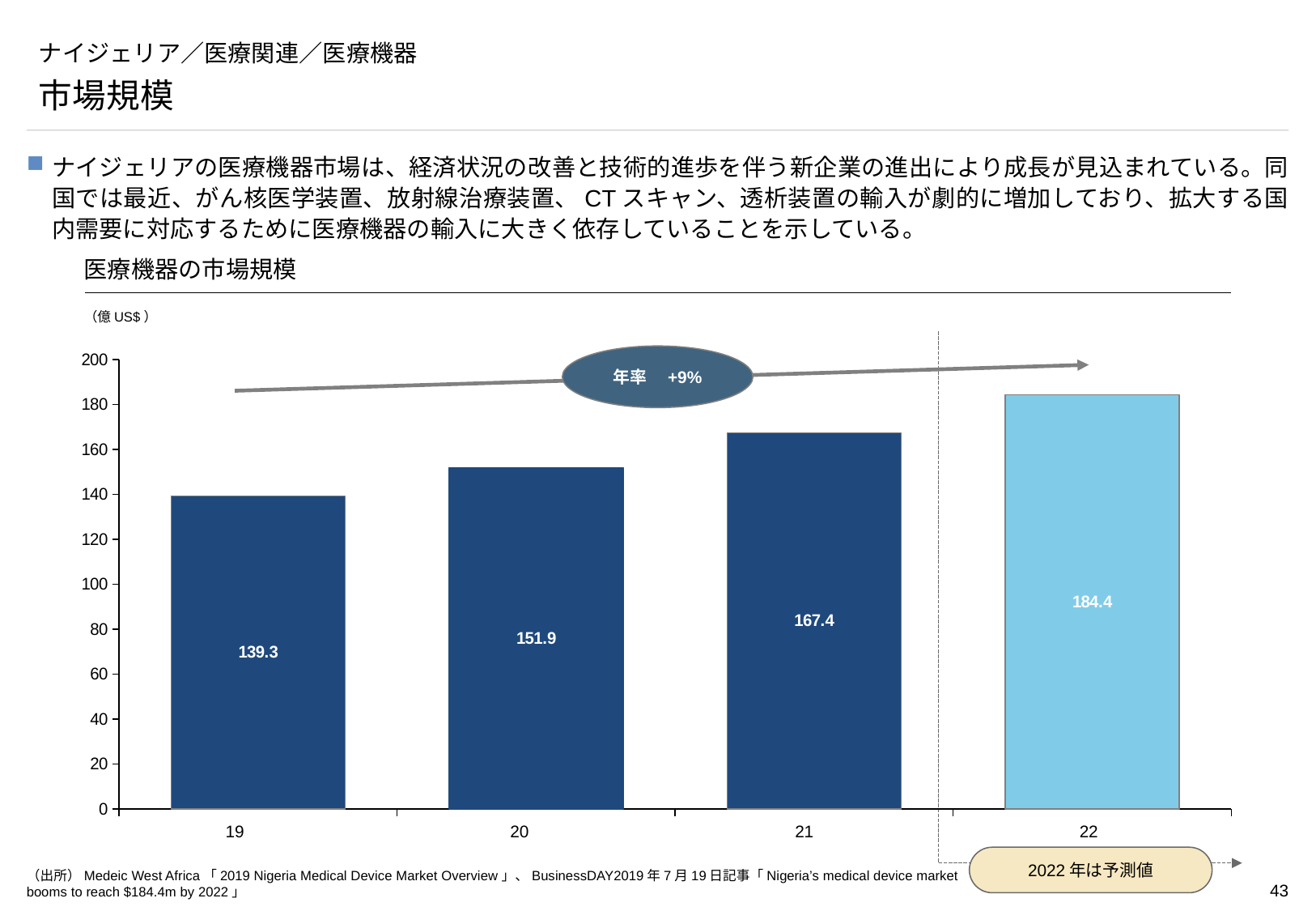
What is the difference between the values for 20 and 19? 12.6 Which category has the highest value? 22 Do the values rise or fall from 19 to 22? rise What is the value for 21 in the chart? 167.4 Which category has the lowest value? 19 What is the difference between the values for 22 and 21? 17.0 What kind of chart is shown? bar chart What is the value for 22 in the chart? 184.4 How many categories are shown on the x axis? 4 What annual growth rate is shown in the oval label on the chart? +9% Which is larger, the value for 20 or the value for 21? 21 What is the value for 19 in the chart? 139.3